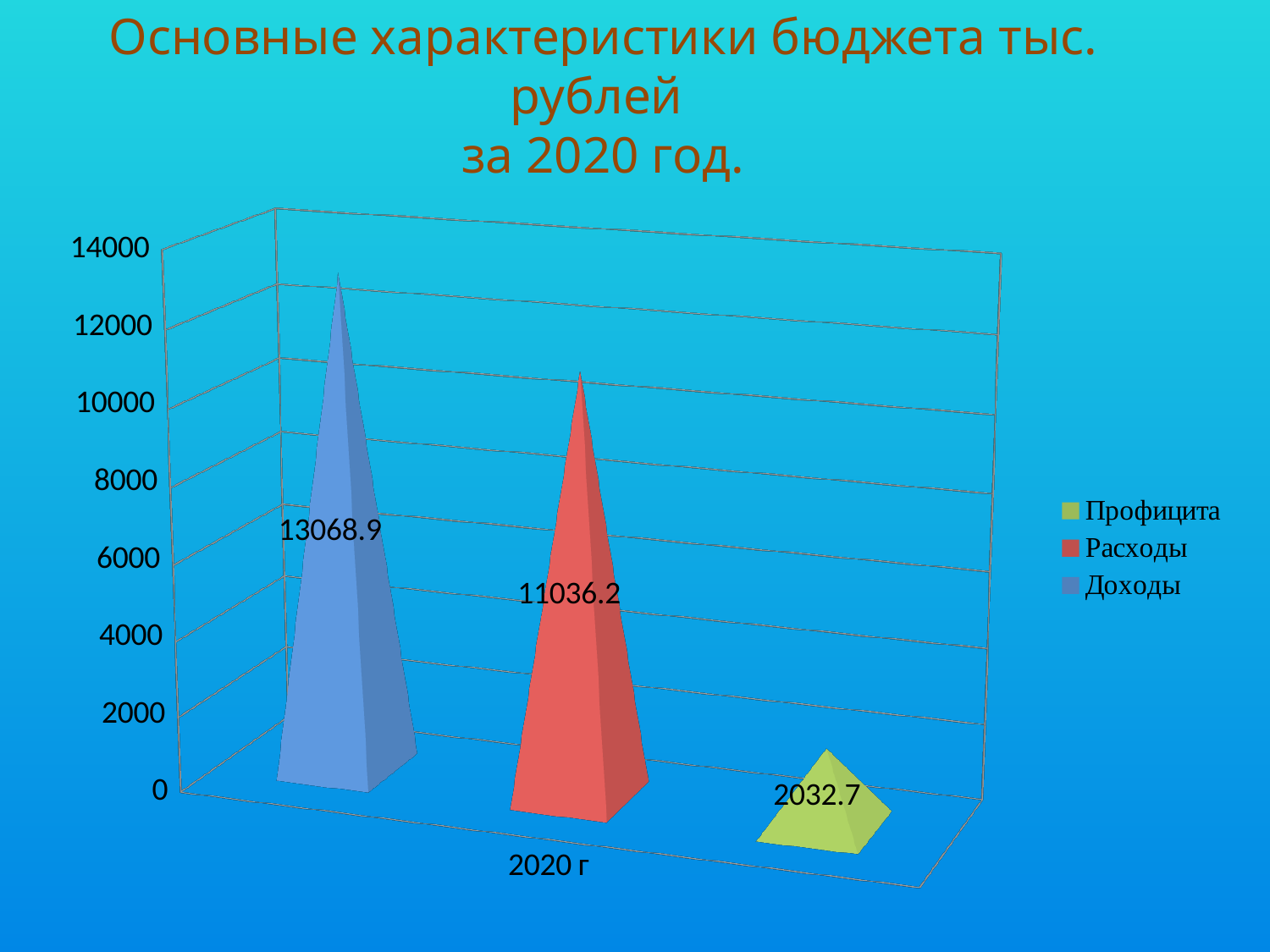
What is the title of the chart? Основные характеристики бюджета тыс. рублей за 2020 год. Which series has the lowest value? Профицита What is the difference between Доходы and Расходы? 2032.7 How many series does the legend list? 3 Which series has the highest value? Доходы What is the value for Доходы in 2020 г? 13068.9 Is the value for Расходы greater or less than 10000? greater What is the value for Расходы in 2020 г? 11036.2 How many categories are shown on the x axis? 1 What is the difference between Расходы and Профицита? 9003.5 Which is larger, Доходы or Расходы? Доходы What is the value for Профицита in 2020 г? 2032.7